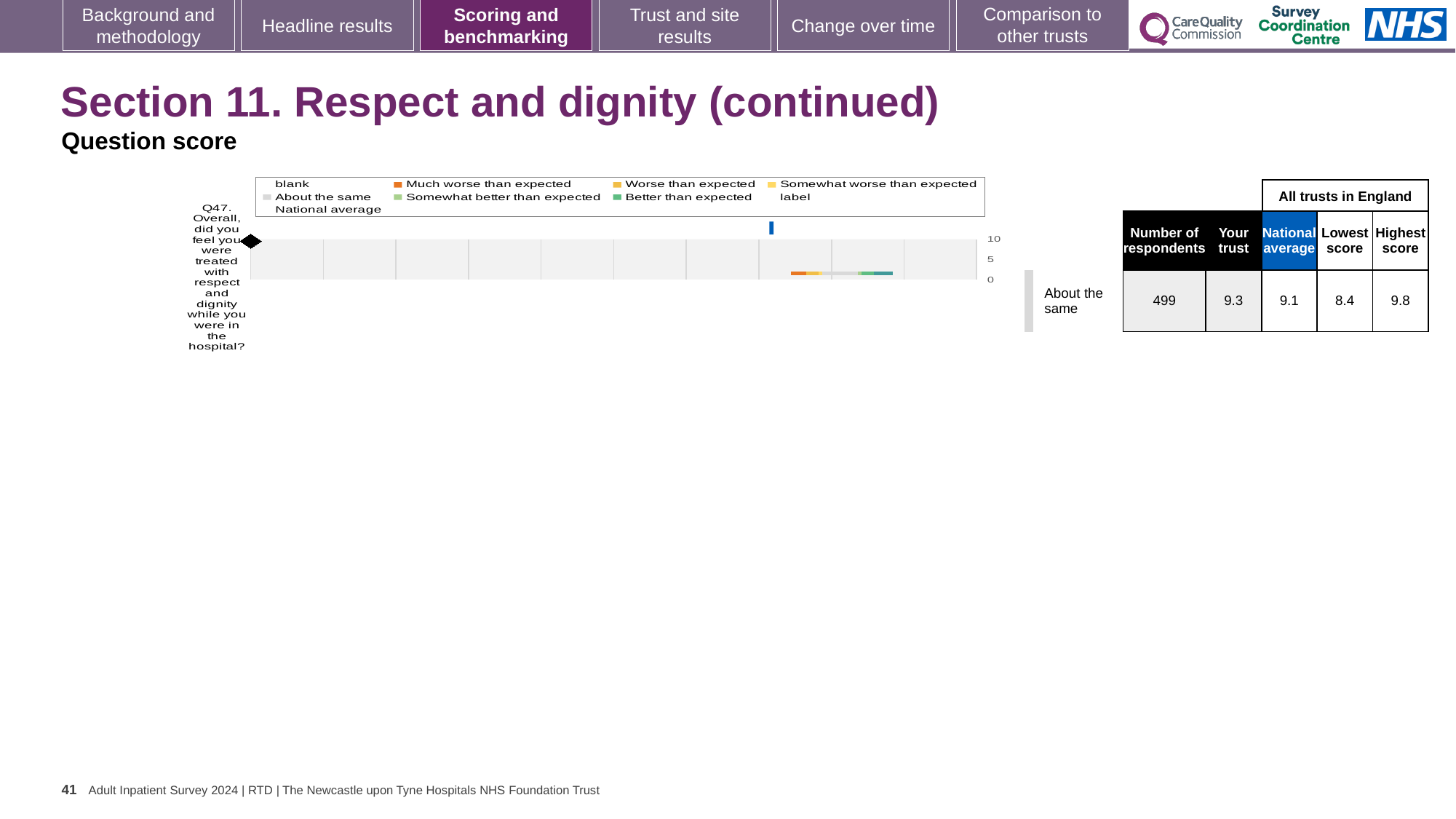
What is the difference between the highest score and the lowest score for Q47? 1.4 How many respondents answered Q47? 499 What is the 'Your trust' score for Q47? 9.3 How many entries does the chart legend list? 9 Which is larger for Q47, the 'Your trust' score or the national average? Your trust What is the highest score among all trusts in England for Q47? 9.8 What colour does the legend use for 'Much worse than expected'? Orange What is the national average score for Q47? 9.1 What benchmark category label is shown for Q47 next to the chart? About the same What kind of chart is shown for Q47 on this slide? Bar chart How many questions (categories) are plotted in the chart? 1